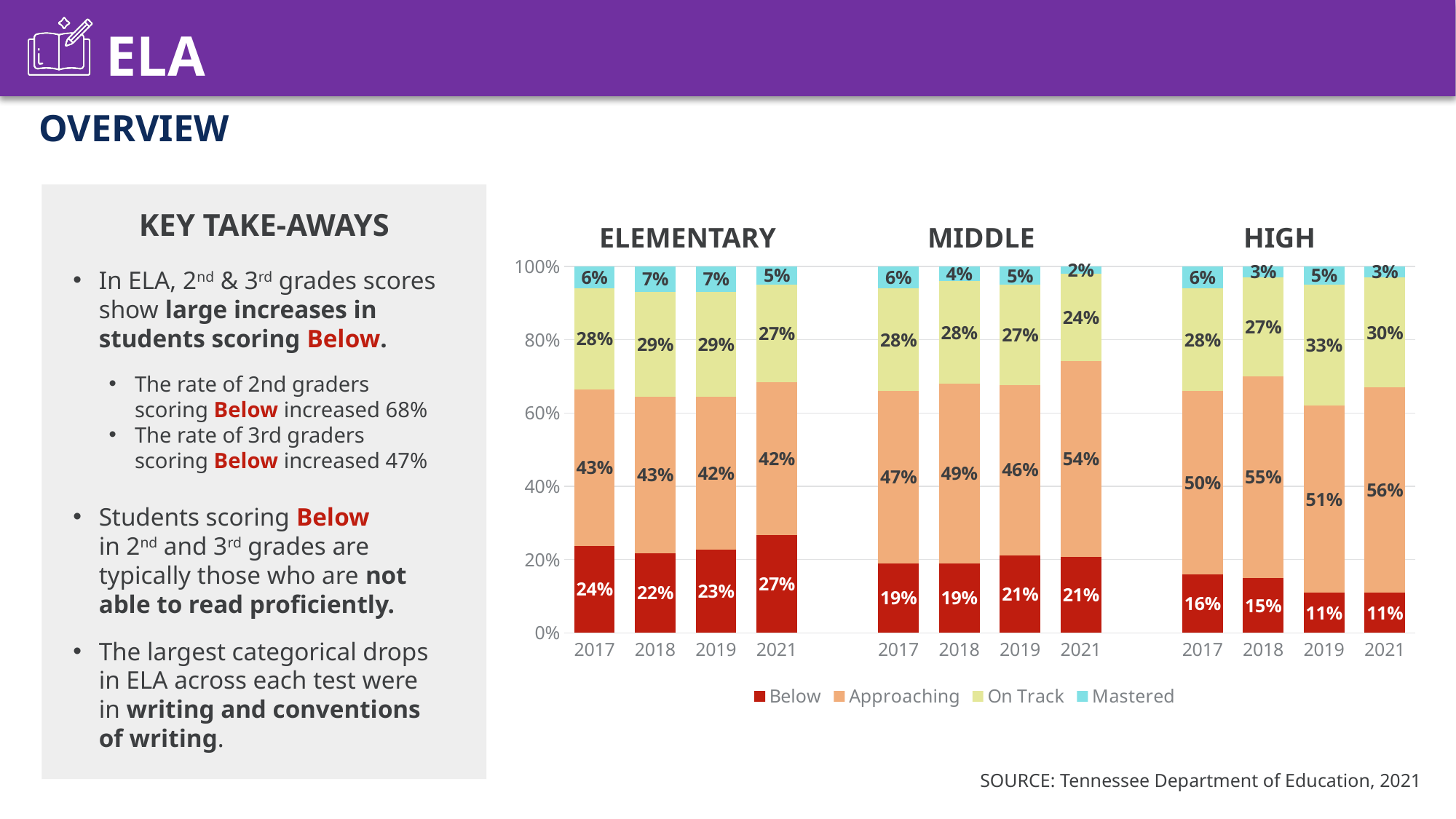
What type of chart is shown on the slide? Stacked bar chart In the High group, which year has the highest Approaching percentage? 2021 By how many percentage points did the Elementary Below share in 2021 exceed the Elementary Below share in 2018? 5 percentage points Does the Below percentage for the High group rise or fall from 2017 to 2021? Fall How many years are shown for each grade group on the chart? 4 Which colour represents the Below category in the chart? Red What percentage of High school students were On Track in 2019? 33% In the Middle group, which year has the lowest Mastered percentage? 2021 Which is larger: the Approaching share for Middle in 2018 or the Approaching share for High in 2018? High in 2018 What percentage of Middle school students were Approaching in 2021? 54% How many series does the chart legend list? 4 What percentage of Elementary students scored Below in 2021? 27%